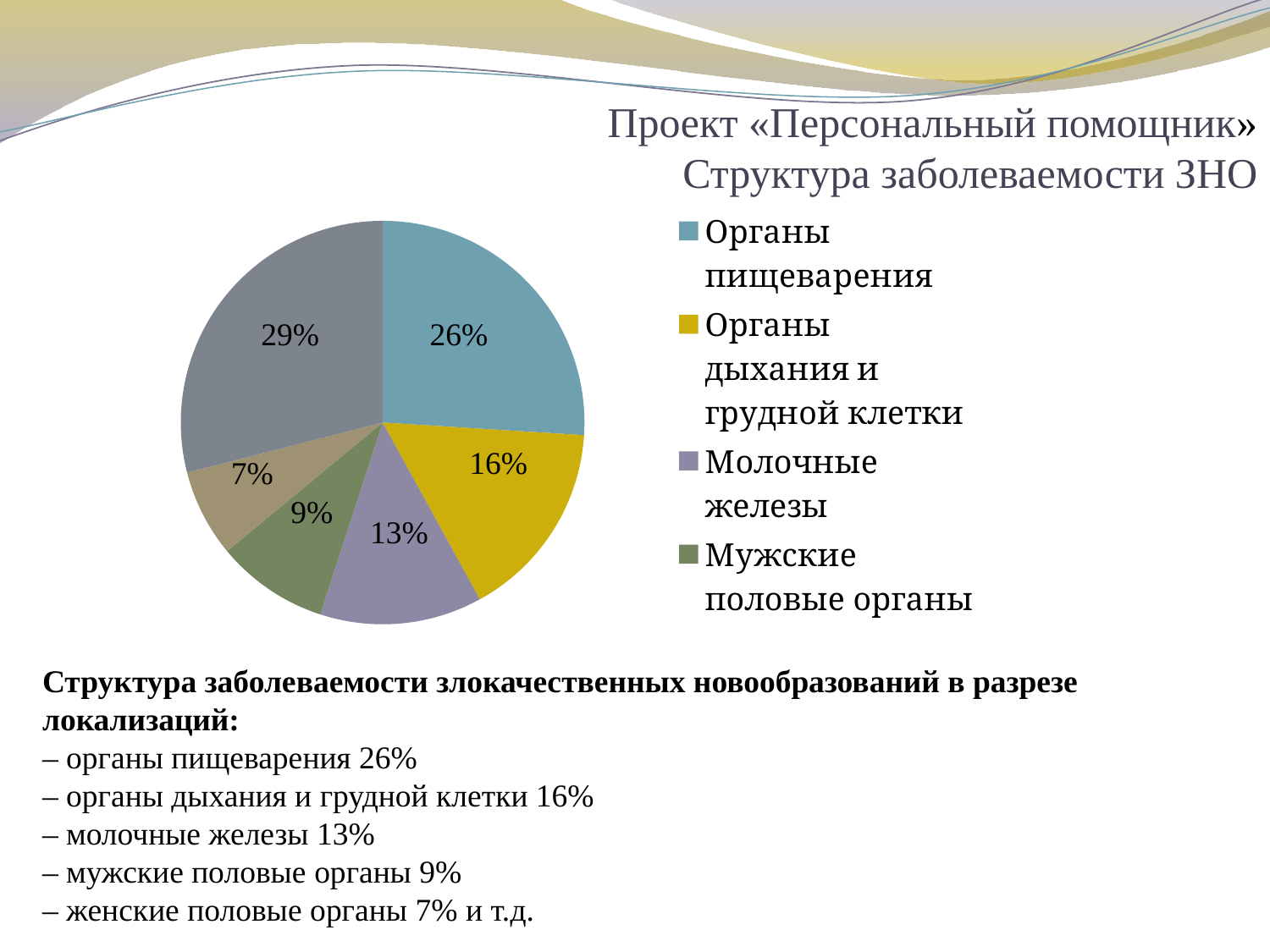
What kind of chart is shown on the slide? Pie chart How many entries does the chart legend list? 4 By how many percentage points does Органы пищеварения exceed Молочные железы in the pie chart? 13 percentage points What is the largest percentage labelled on the pie chart? 29% What colour is the Органы пищеварения slice in the pie chart? Blue (teal) Which has the larger share in the pie chart, Органы дыхания и грудной клетки or Мужские половые органы? Органы дыхания и грудной клетки What percentage does the pie chart show for Мужские половые органы? 9% What percentage does the pie chart show for Органы пищеварения? 26% How many slices does the pie chart have? 6 What is the smallest percentage labelled on the pie chart? 7% What percentage does the pie chart show for Молочные железы? 13% What percentage does the pie chart show for Органы дыхания и грудной клетки? 16%